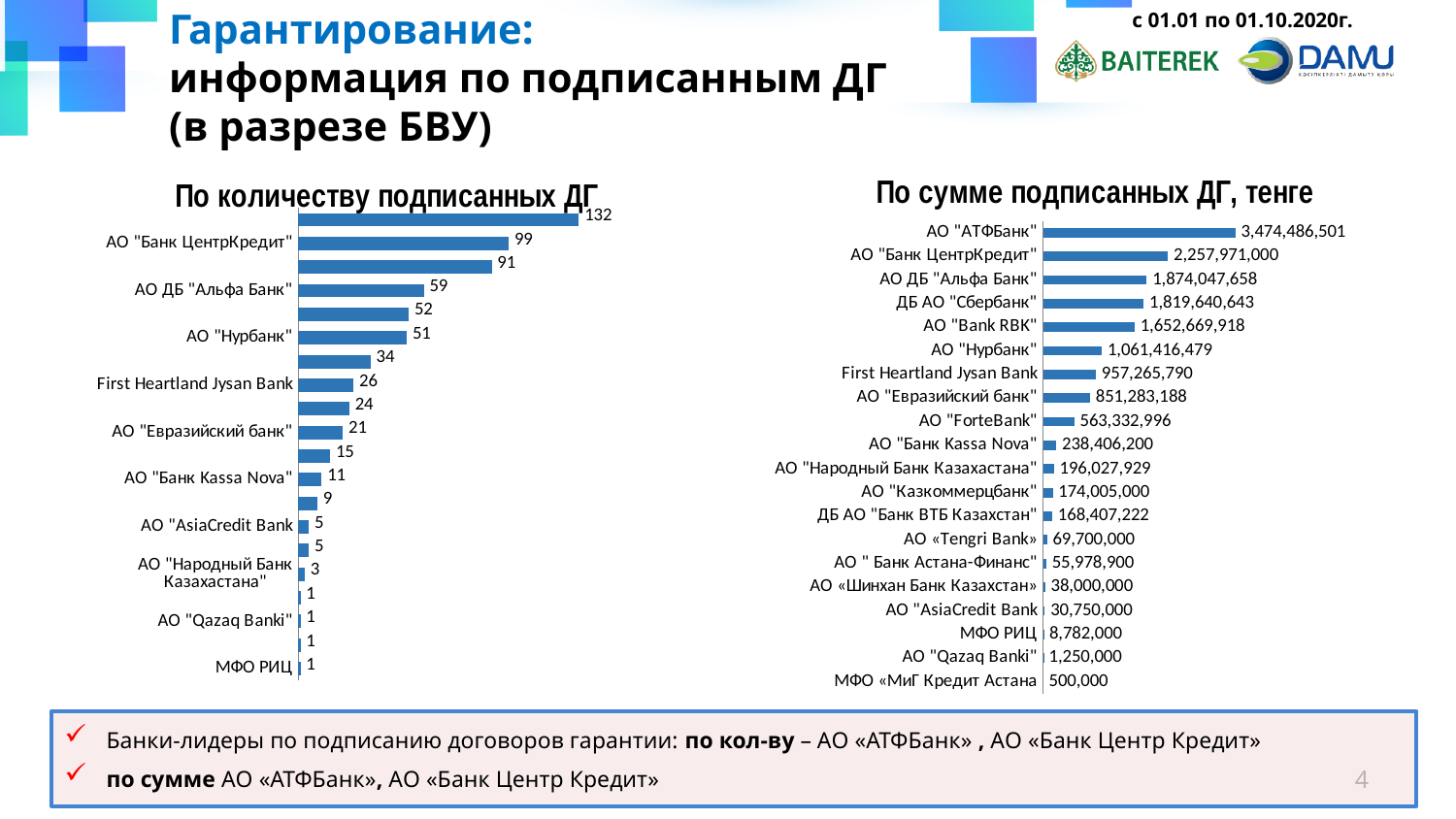
In the chart "По количеству подписанных ДГ", what is the value for АО ДБ "Альфа Банк"? 59 In the chart "По количеству подписанных ДГ", what is the value for АО "Банк ЦентрКредит"? 99 In the chart "По сумме подписанных ДГ, тенге", which bank has the highest value? АО "АТФБанк" In the chart "По сумме подписанных ДГ, тенге", what is the value for АО "АТФБанк"? 3,474,486,501 In the chart "По сумме подписанных ДГ, тенге", what is the value for АО "Нурбанк"? 1,061,416,479 What type of chart is "По количеству подписанных ДГ"? Bar chart What is the title of the chart on the right side of the slide? По сумме подписанных ДГ, тенге In the chart "По сумме подписанных ДГ, тенге", which category has the lowest value? МФО «МиГ Кредит Астана» In the chart "По сумме подписанных ДГ, тенге", which is larger: АО "ForteBank" or АО "Евразийский банк"? АО "Евразийский банк" In the chart "По сумме подписанных ДГ, тенге", how many categories are shown? 20 In the chart "По количеству подписанных ДГ", what is the difference between АО "Нурбанк" and First Heartland Jysan Bank? 25 In the chart "По сумме подписанных ДГ, тенге", what is the difference between АО "АТФБанк" and АО "Банк ЦентрКредит"? 1,216,515,501